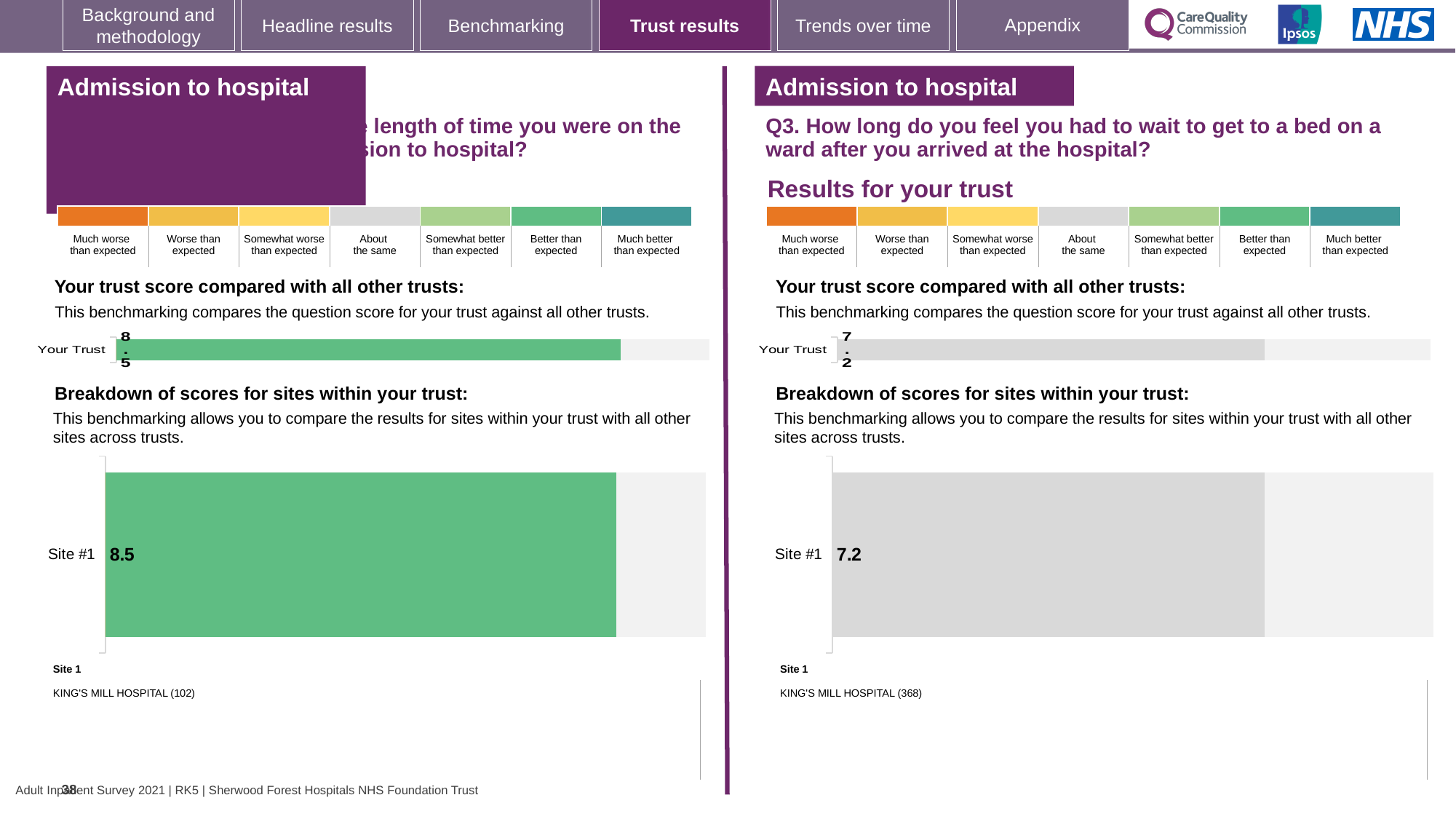
On the right-hand Q3 chart, which benchmark category does the grey colour of the Site #1 bar correspond to? About the same On the left-hand chart, which benchmark category does the green colour of the Site #1 bar correspond to? Better than expected What is the difference between the Site #1 score on the left-hand chart and the Site #1 score on the right-hand Q3 chart? 1.3 Which site is listed as Site 1 beneath the left-hand chart, and how many respondents are shown in brackets? KING'S MILL HOSPITAL (102) What kind of chart is used to show the Site #1 score on the right-hand Q3 chart? Bar chart On the left-hand chart (length of time on the waiting list before admission), what is the score shown for Site #1? 8.5 Which is larger: the Site #1 score on the left-hand chart or the Site #1 score on the right-hand Q3 chart? Left-hand chart (8.5) On the right-hand chart for Q3 (wait to get to a bed on a ward), what is the score shown for Your Trust? 7.2 Which site is listed as Site 1 beneath the right-hand Q3 chart, and how many respondents are shown in brackets? KING'S MILL HOSPITAL (368) On the right-hand chart for Q3 (wait to get to a bed on a ward), what is the score shown for Site #1? 7.2 On the left-hand chart (length of time on the waiting list before admission), what is the score shown for Your Trust? 8.5 How many sites are shown in the site breakdown chart on the right-hand Q3 chart? 1